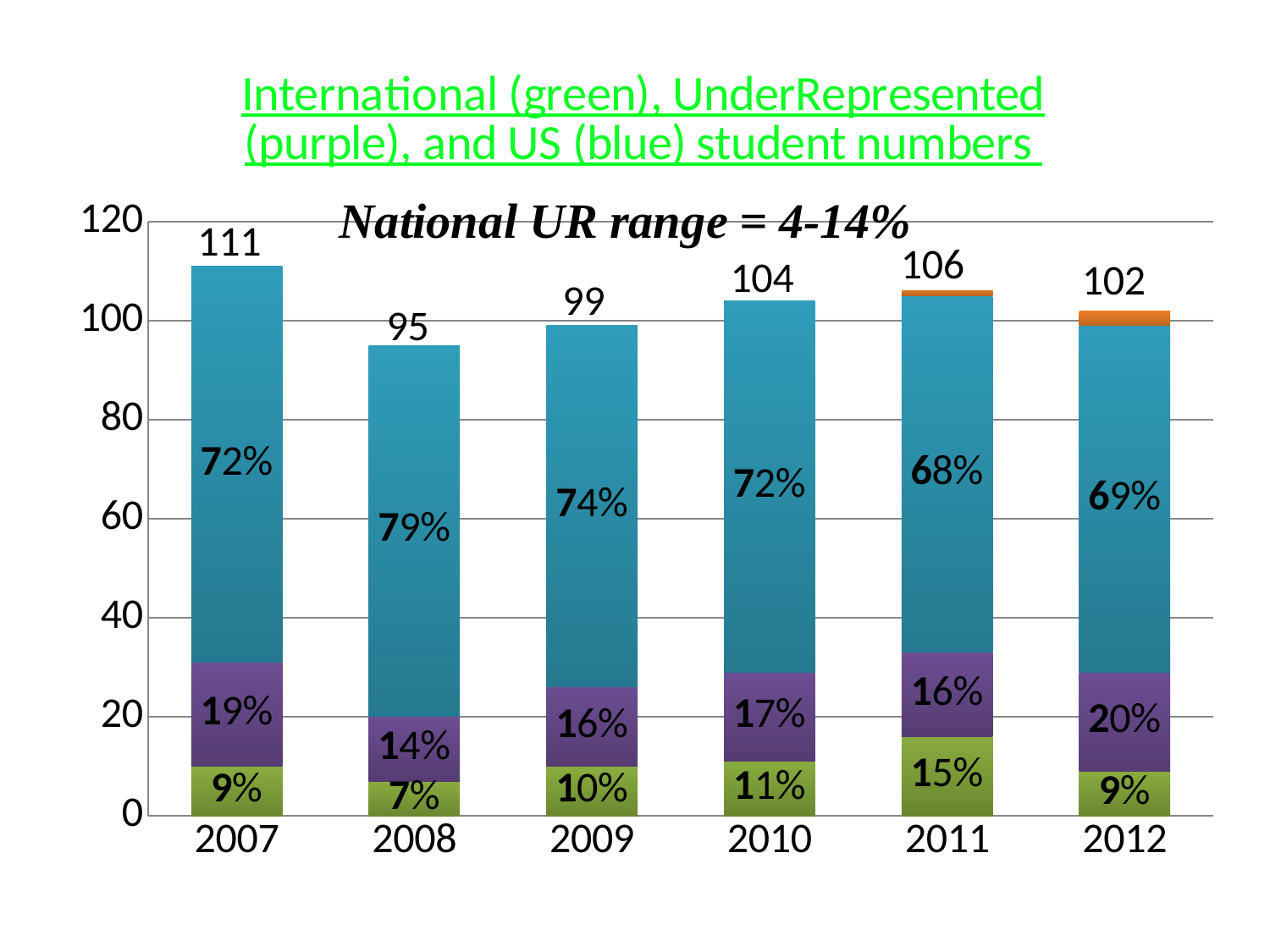
Which year has the lowest total student number? 2008 What is the total student number shown above the bar for 2007? 111 Is the total student number for 2009 greater or less than 100? less What percentage is labelled on the blue (US) segment for 2008? 79% What is the difference between the total student numbers for 2007 and 2008? 16 According to the text on the chart, what is the national UR range? 4-14% Which year has the larger total student number, 2010 or 2012? 2010 What percentage is labelled on the purple (UnderRepresented) segment for 2012? 20% What percentage is labelled on the green (International) segment for 2011? 15% Which year has the highest total student number? 2007 What kind of chart is shown on the slide? Stacked bar chart How many years are shown on the x axis of the chart? 6